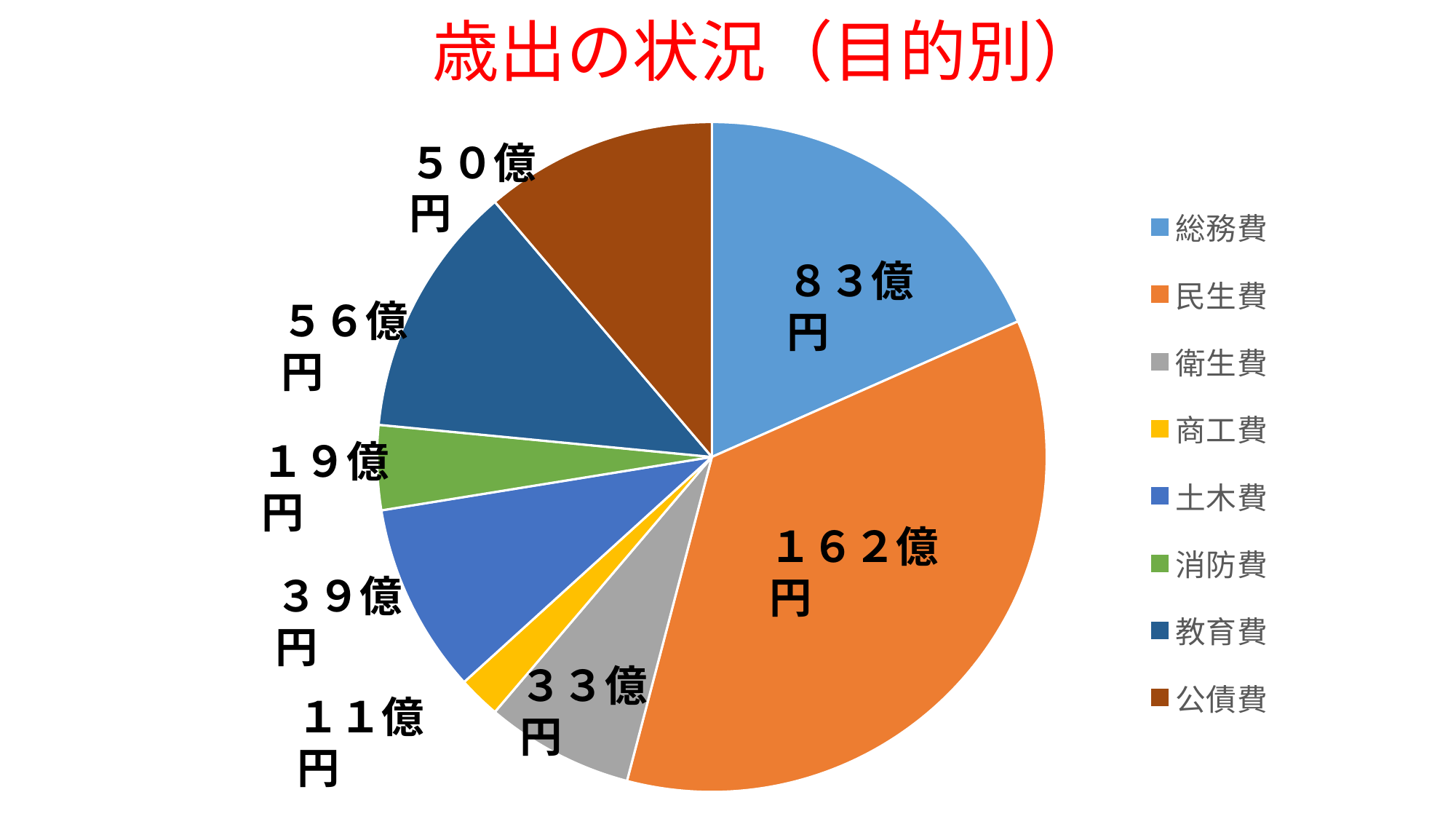
How many categories does the pie chart show? 8 Which category has the smallest slice of the pie? 商工費 What is the title of the chart? 歳出の状況（目的別） What is the value for 教育費? 56億円 What is the difference between 教育費 and 公債費? 6億円 What is the value for 民生費? 162億円 Which category has the largest slice of the pie? 民生費 What kind of chart is shown on the slide? Pie chart What is the difference between 民生費 and 総務費? 79億円 Which is larger, 土木費 or 衛生費? 土木費 What is the value for 商工費? 11億円 What is the value for 総務費? 83億円